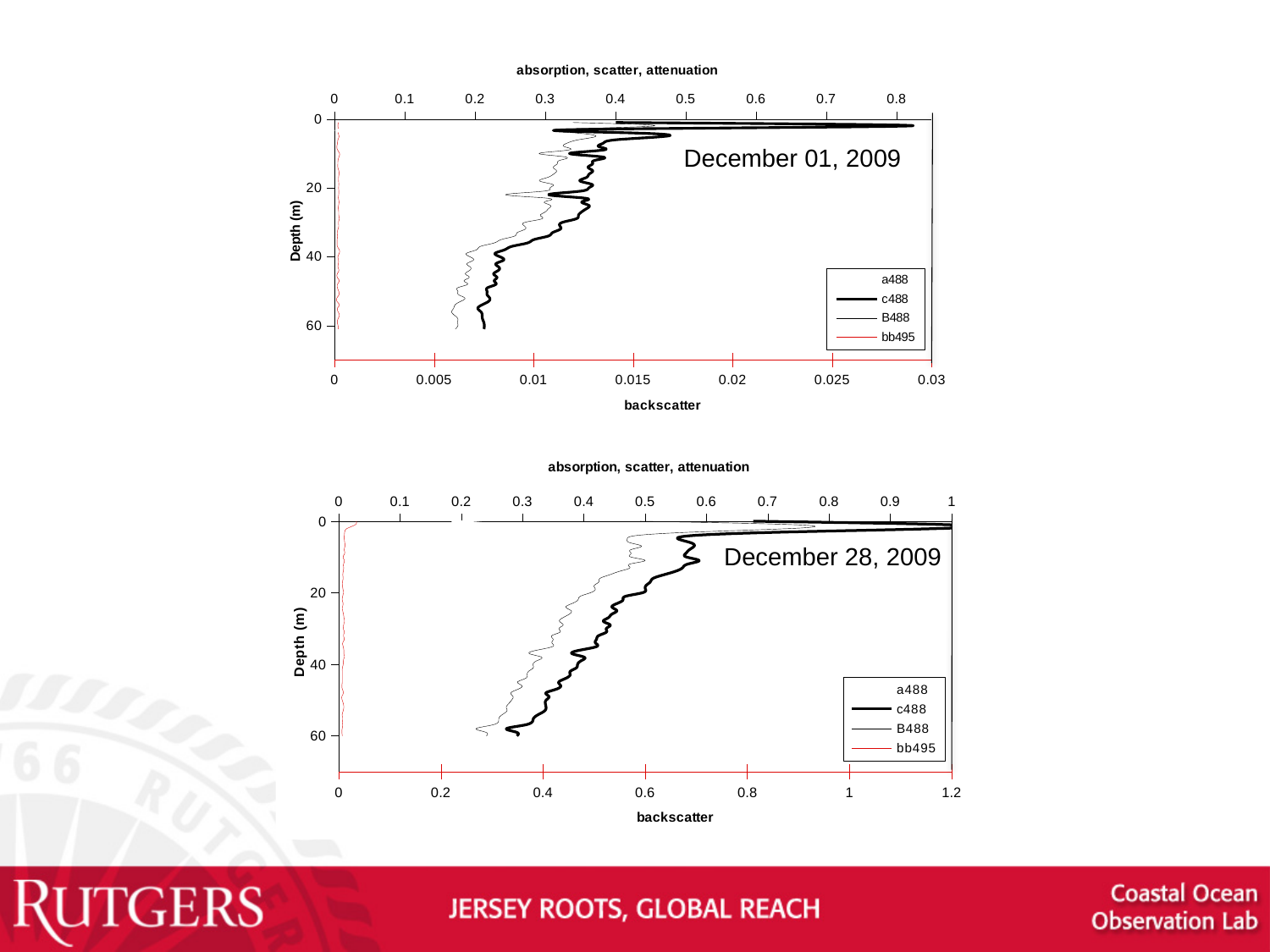
How many series does the legend of the December 01, 2009 chart list? 4 In the December 01, 2009 chart, is the c488 value at a depth of 60 m greater or less than 0.3? less In the December 28, 2009 chart, is the B488 value at a depth of 60 m greater or less than 0.3? less In the December 01, 2009 chart, is the B488 value at a depth of 60 m greater or less than 0.2? less In the December 28, 2009 chart, does the B488 value generally rise or fall as depth increases from 10 m to 60 m? fall In the December 01, 2009 chart, does the c488 value generally rise or fall as depth increases from 10 m to 60 m? fall In the December 28, 2009 chart, what is the title of the bottom horizontal axis? backscatter How many series does the legend of the December 28, 2009 chart list? 4 What kind of chart is the top chart labelled December 01, 2009? line chart In the December 01, 2009 chart, what is the label of the vertical axis? Depth (m) In the December 28, 2009 chart, at a depth of 40 m, which series has the larger value, c488 or B488? c488